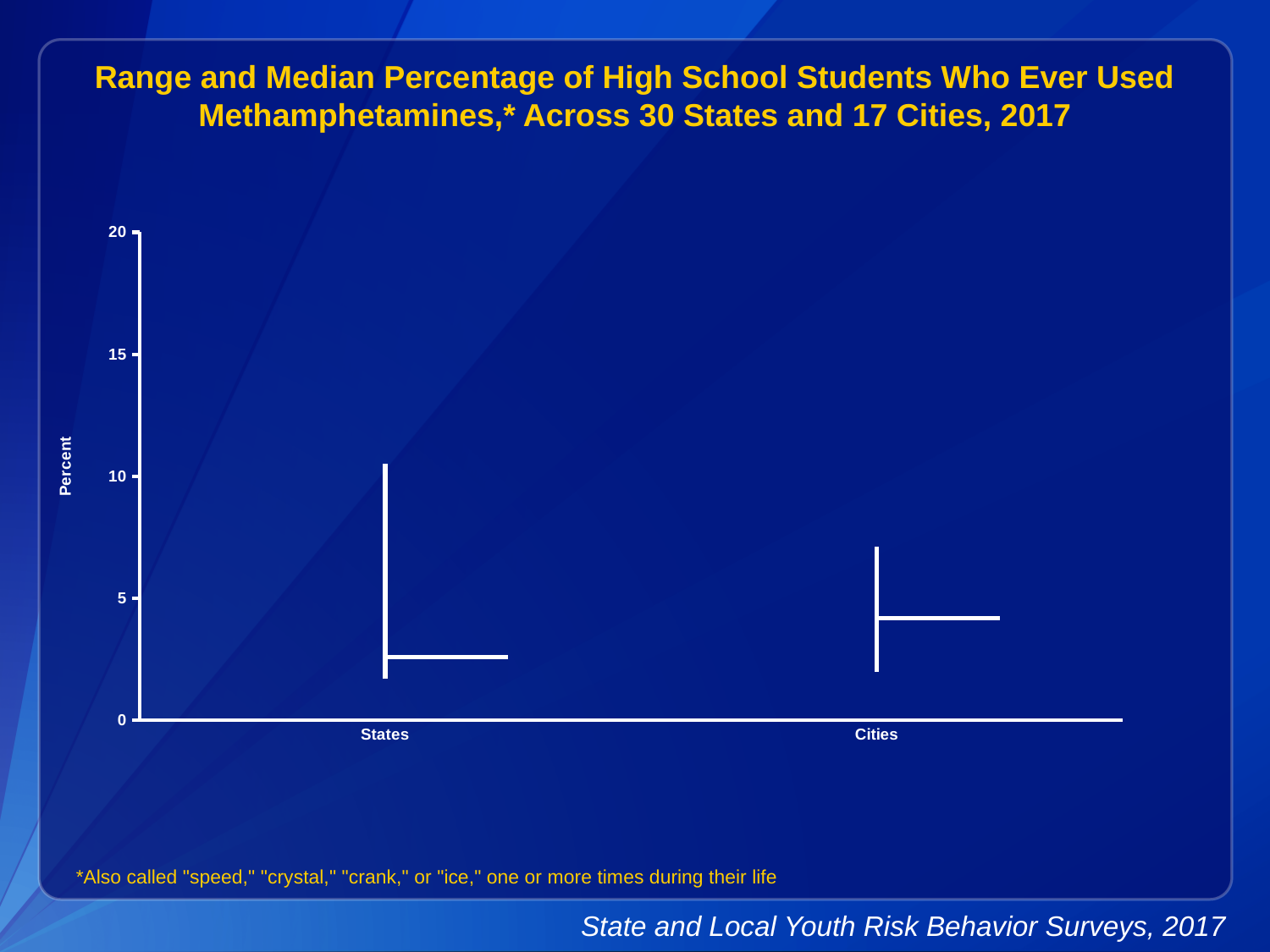
Is the top of the range for States greater or less than 5? greater Is the median value for Cities greater or less than 5? less Is the bottom of the range for Cities greater or less than 5? less What is the label of the y axis? Percent Which category has the higher top of its range, States or Cities? States What are the two categories shown on the x axis? States and Cities How many categories are shown on the x axis of the chart? 2 Which category has the higher median, States or Cities? Cities Which category has the wider range of values? States What is the highest value shown on the y axis? 20